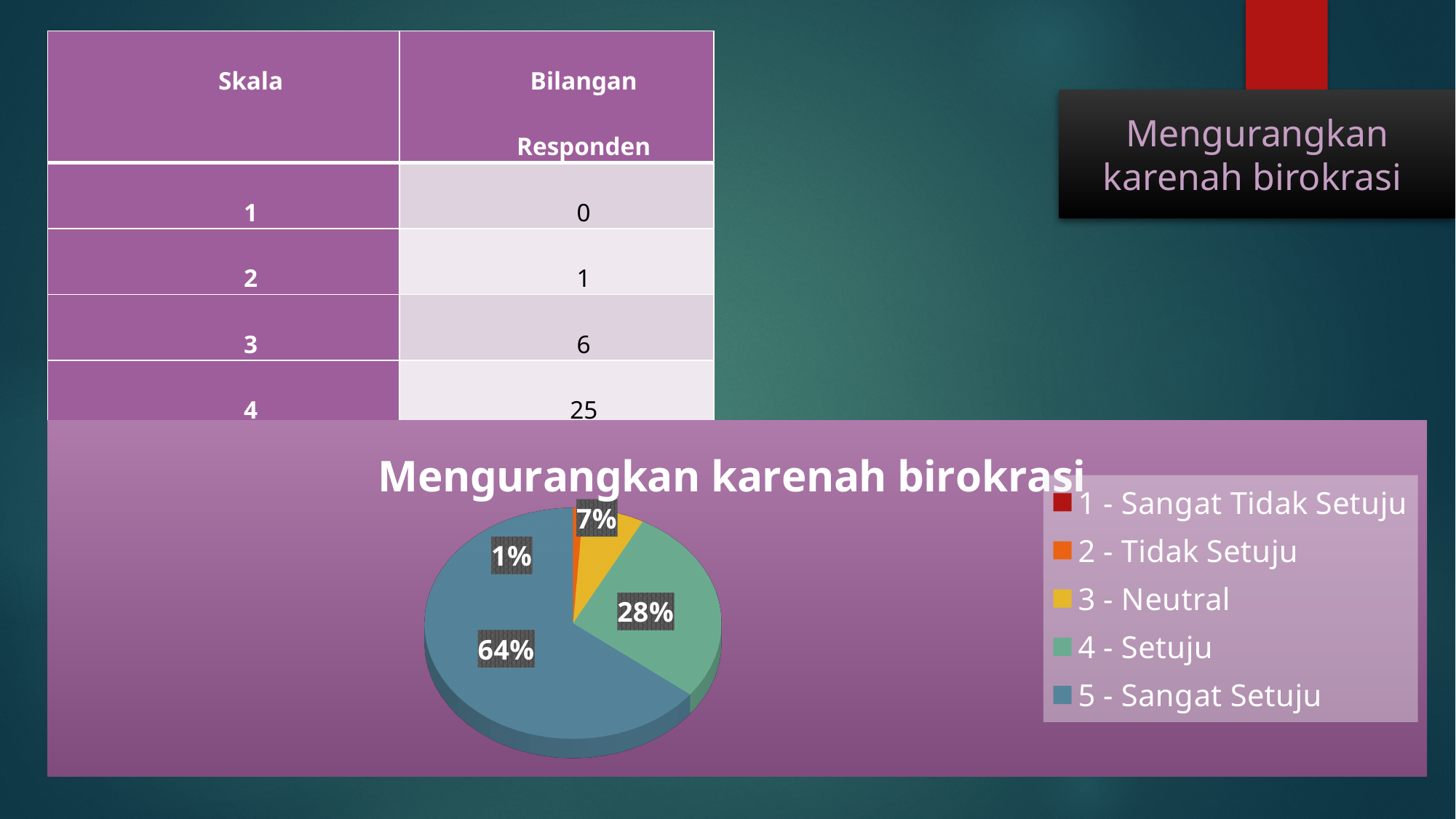
What is the title of the chart? Mengurangkan karenah birokrasi What kind of chart is shown on the slide? Pie chart Which labelled slice of the pie is the smallest? 2 - Tidak Setuju What percentage is shown for 3 - Neutral? 7% What share of the pie does 5 - Sangat Setuju represent? 64% What percentage is shown for 2 - Tidak Setuju? 1% What is the difference in percentage points between 5 - Sangat Setuju and 4 - Setuju? 36 Which is larger, the slice for 3 - Neutral or the slice for 4 - Setuju? 4 - Setuju How many categories does the legend list? 5 What share of the pie does 4 - Setuju represent? 28% What colour is the slice for 4 - Setuju? Green Which category has the largest slice of the pie? 5 - Sangat Setuju